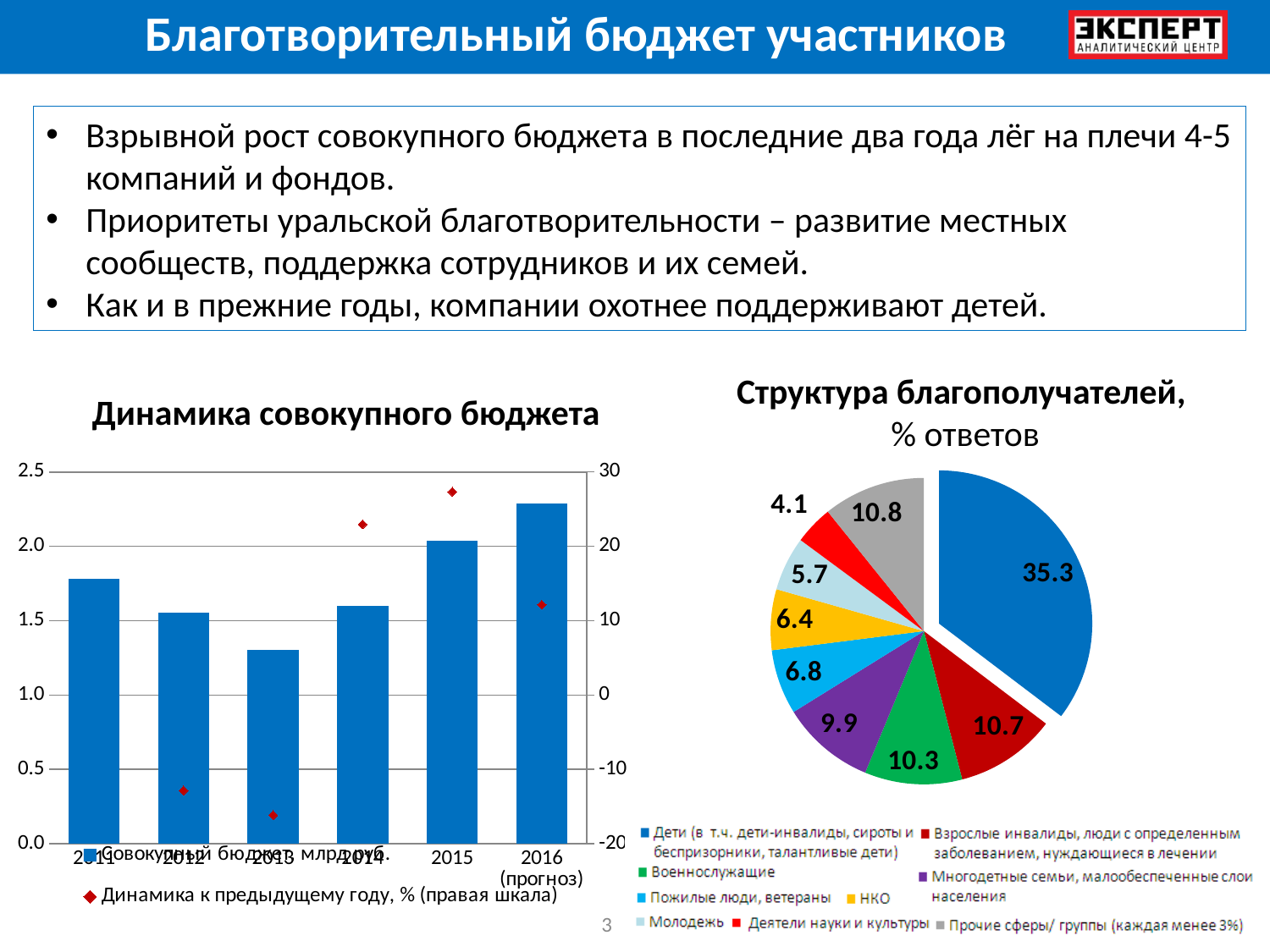
In the pie chart 'Структура благополучателей', what is the difference between the slice for Дети (35.3) and the slice for Взрослые инвалиды (10.7)? 24.6 In the chart 'Динамика совокупного бюджета', is the bar for 2013 greater or less than 1.5? less In the pie chart 'Структура благополучателей', what is the smallest slice value? 4.1 In the pie chart 'Структура благополучателей', which category has the largest share? Дети (в т.ч. дети-инвалиды, сироты и беспризорники, талантливые дети) How many slices does the pie chart 'Структура благополучателей' have? 9 In the pie chart 'Структура благополучателей', what is the value of the largest slice? 35.3 In the chart 'Динамика совокупного бюджета', which year has the tallest bar? 2016 (прогноз) What kind of chart is 'Структура благополучателей'? pie chart In the chart 'Динамика совокупного бюджета', which year has the shortest bar? 2013 How many series does the legend of 'Динамика совокупного бюджета' list? 2 In the pie chart 'Структура благополучателей', what is the value for Военнослужащие? 10.3 In the pie chart 'Структура благополучателей', what is the value for НКО? 6.4